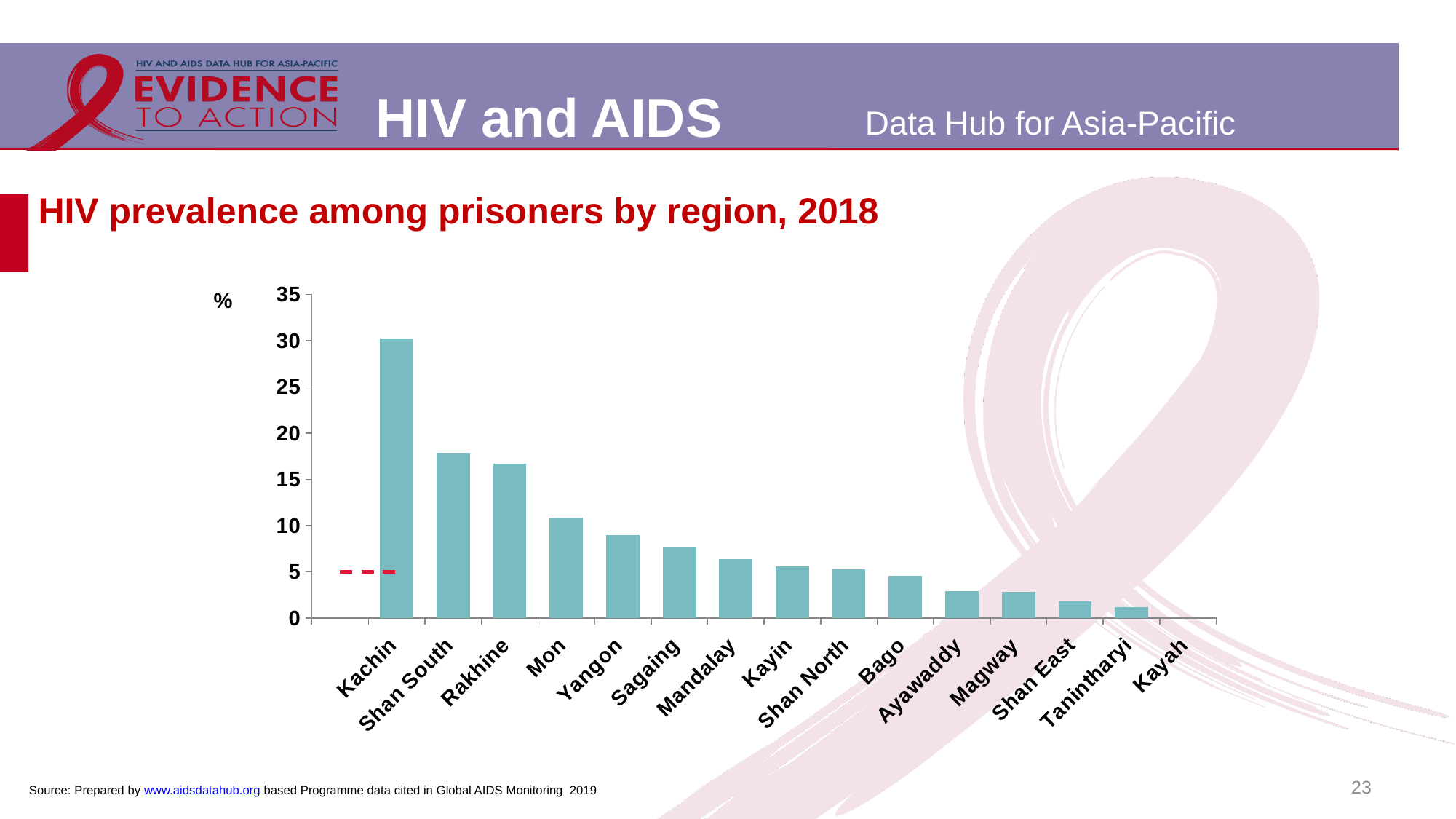
Is the value for Shan South greater or less than 15? greater Do the bar values rise or fall moving from left to right along the x axis? fall Which region has the shortest visible bar in the chart? Tanintharyi Is the value for Kachin greater or less than 25? greater What is the title of the chart? HIV prevalence among prisoners by region, 2018 How many regions are shown on the x axis of the chart? 15 What unit is indicated on the y axis of the chart? % Is the value for Yangon greater or less than 10? less What type of chart is shown on the slide? bar chart Which region has the highest HIV prevalence among prisoners? Kachin Which has a higher HIV prevalence among prisoners, Mon or Yangon? Mon